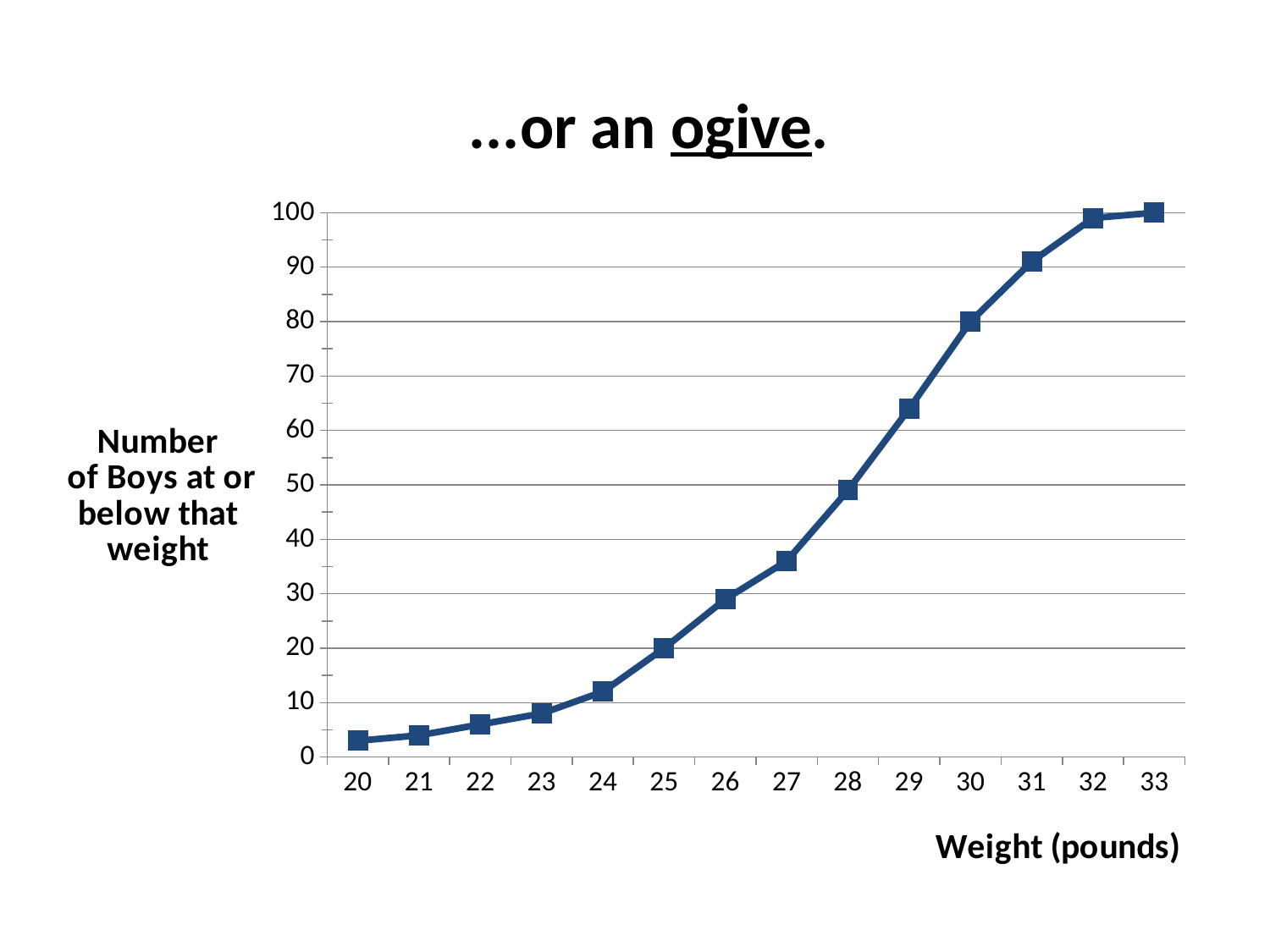
Is the value for 27 pounds greater or less than 40? less Is the value for 28 pounds greater or less than 40? greater Which weight has the lowest number of boys at or below it? 20 How many weight values are plotted along the x axis? 14 What is the number of boys at or below 25 pounds? 20 Do the values rise or fall as weight increases along the x axis? rise What is the label of the x axis? Weight (pounds) What is the number of boys at or below 30 pounds? 80 What kind of chart is shown on the slide? line chart What is the number of boys at or below 33 pounds? 100